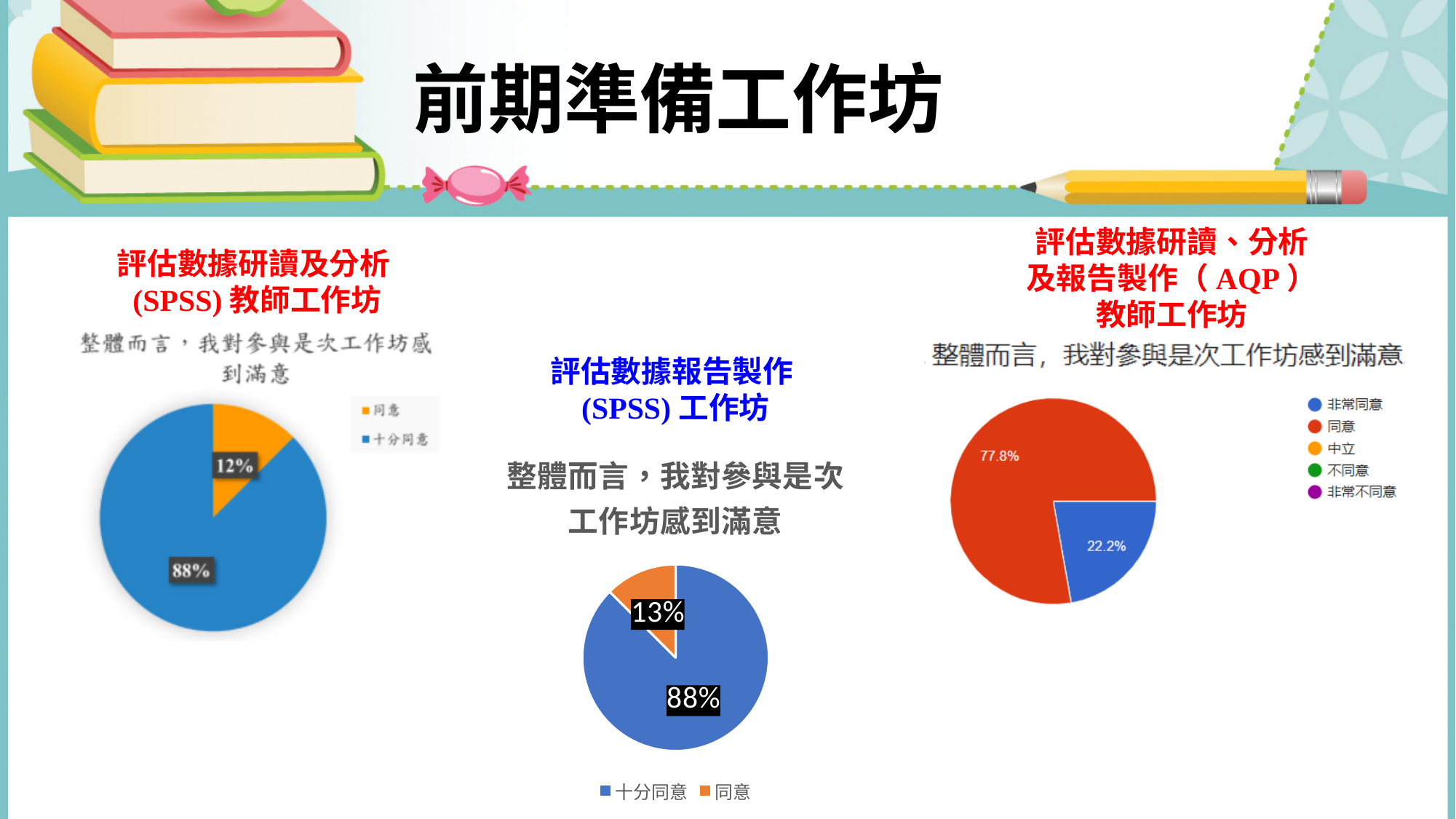
In the middle pie chart (評估數據報告製作 (SPSS) 工作坊), which is larger, 十分同意 or 同意? 十分同意 In the right pie chart (AQP 教師工作坊), what percentage is labelled for 同意? 77.8% In the middle pie chart (評估數據報告製作 (SPSS) 工作坊), what percentage is labelled for 十分同意? 88% In the left pie chart (評估數據研讀及分析 (SPSS) 教師工作坊), what percentage is labelled for 十分同意? 88% In the right pie chart (AQP 教師工作坊), what is the difference between the 同意 and 非常同意 percentages? 55.6% In the left pie chart (評估數據研讀及分析 (SPSS) 教師工作坊), what percentage is labelled for 同意? 12% What type of chart is used for the middle chart (評估數據報告製作 (SPSS) 工作坊)? Pie chart How many entries does the legend of the right pie chart (AQP 教師工作坊) list? 5 In the left pie chart (評估數據研讀及分析 (SPSS) 教師工作坊), which category has the smallest slice? 同意 In the middle pie chart (評估數據報告製作 (SPSS) 工作坊), what percentage is labelled for 同意? 13% In the right pie chart (AQP 教師工作坊), which category has the largest slice? 同意 In the right pie chart (AQP 教師工作坊), what percentage is labelled for 非常同意? 22.2%